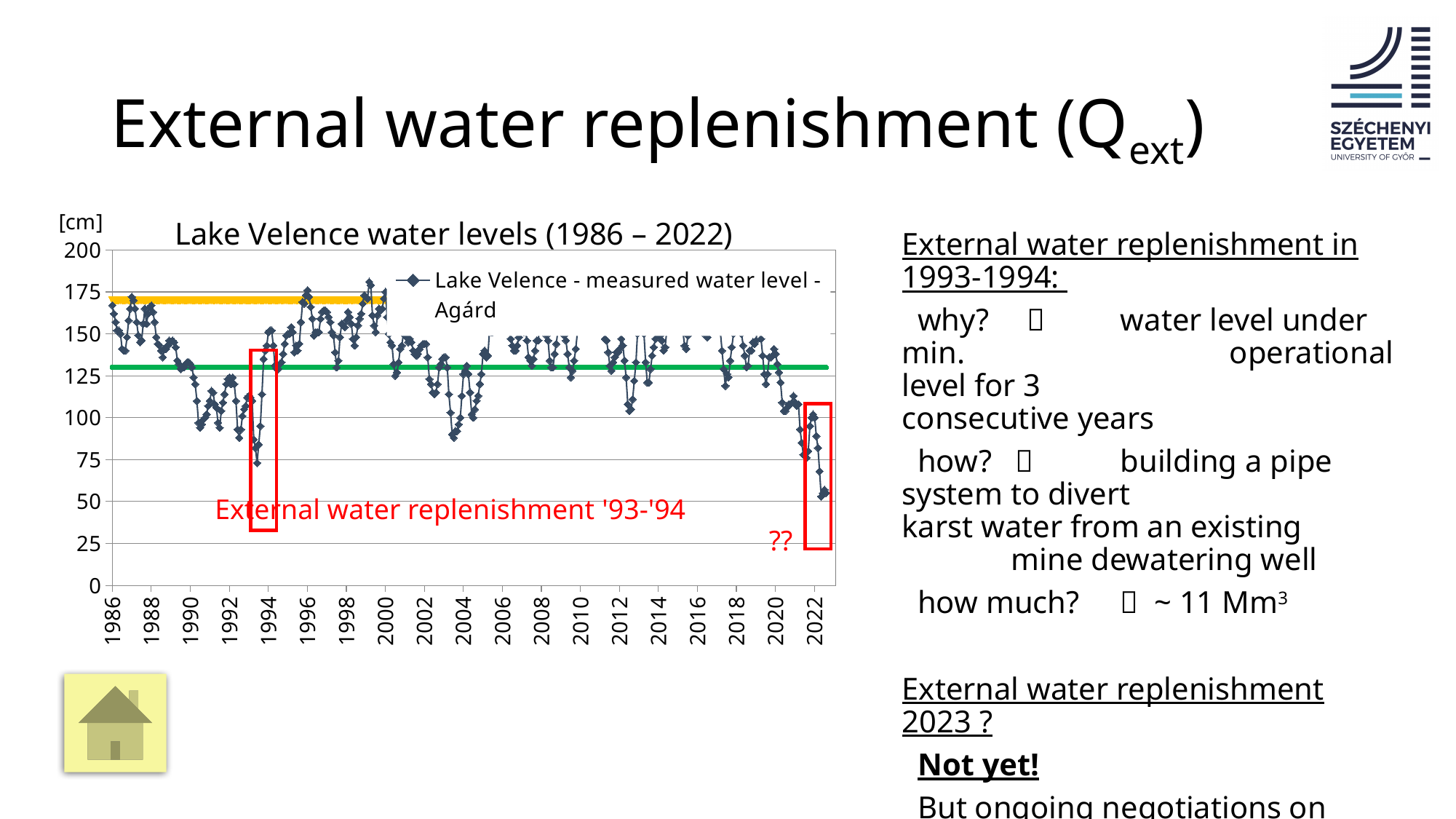
What is the name of the series in the chart legend? Lake Velence - measured water level - Agárd What kind of chart is shown on the slide? line chart Is the highest water level around 1999 greater or less than 150? greater Do the water levels rise or fall between 2020 and 2022? fall What unit is shown on the vertical axis of the chart? cm Is the lowest water level around 2004 greater or less than 100? less Is the lowest water level around 1993 greater or less than 100? less How many series does the chart legend list? 1 Which is higher, the water level around 1999 or the water level around 2022? around 1999 How many year labels are shown on the horizontal axis of the chart? 19 What is the title of the chart? Lake Velence water levels (1986 – 2022)